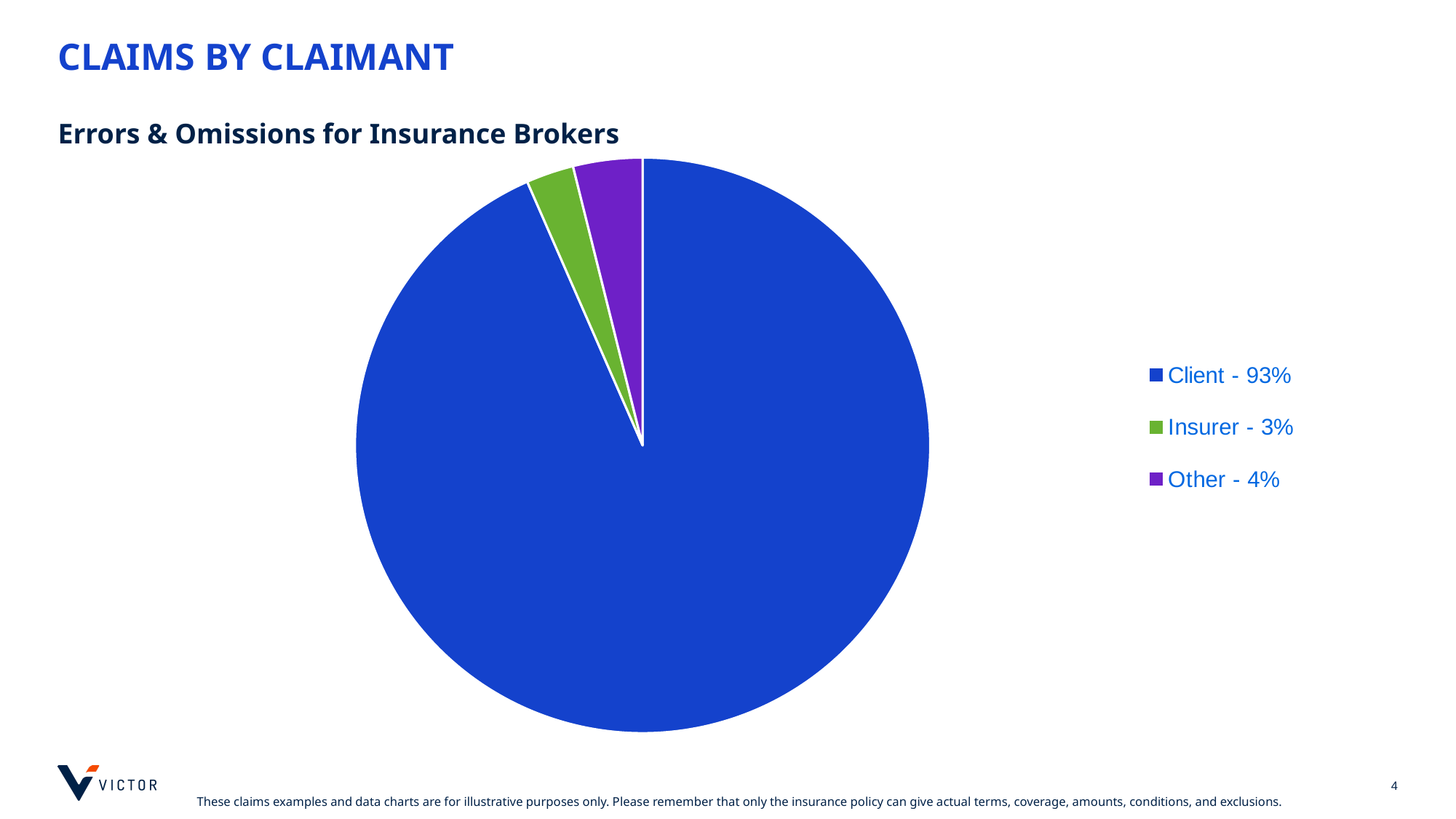
What is the difference in percentage points between the Other share and the Insurer share? 1 Which claimant category has the largest share of claims? Client What share of claims is attributed to Insurer? 3% What is the subtitle shown above the pie chart? Errors & Omissions for Insurance Brokers What is the difference in percentage points between the Client share and the Other share? 89 What share of claims is attributed to Other? 4% What share of claims is attributed to Client? 93% What colour is the Client slice in the pie chart? Blue Which claimant category has the smallest share of claims? Insurer Which is larger, the share for Other or the share for Insurer? Other How many categories does the pie chart show? 3 What kind of chart is shown on the slide? Pie chart